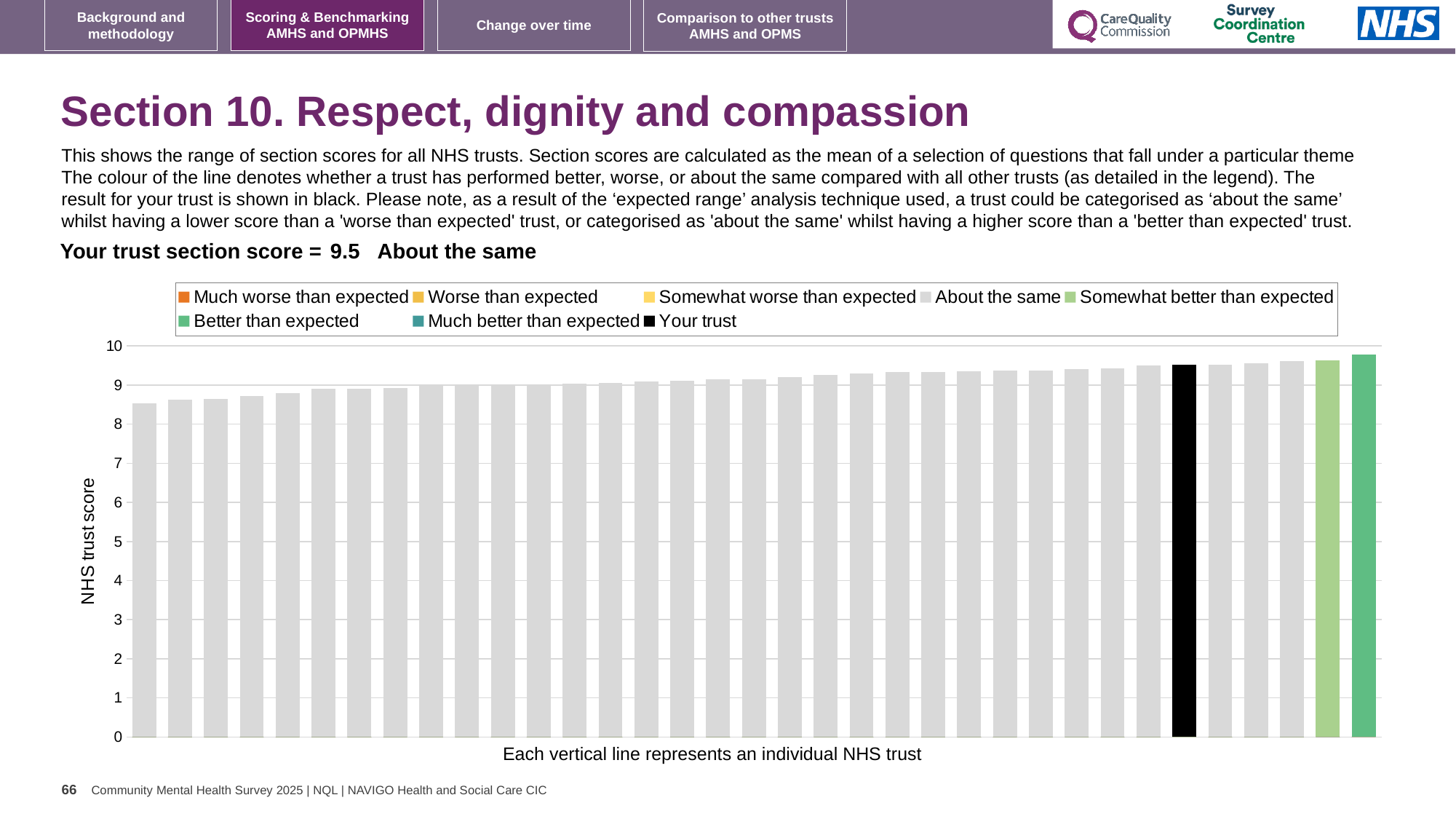
Is the value of the leftmost bar greater or less than 9? less Which bar is the highest: the leftmost bar or the rightmost bar? the rightmost bar What is the section score for your trust, as shown on the slide? 9.5 Do the bar values rise or fall from left to right along the x axis? rise What is the label on the vertical axis of the chart? NHS trust score What kind of chart is shown on the slide? bar chart Is the value of the leftmost bar greater or less than 8? greater How many entries does the chart legend list? 8 Is the value of the black 'Your trust' bar greater or less than 9? greater What colour is the bar representing your trust? black What is the maximum value shown on the vertical axis? 10